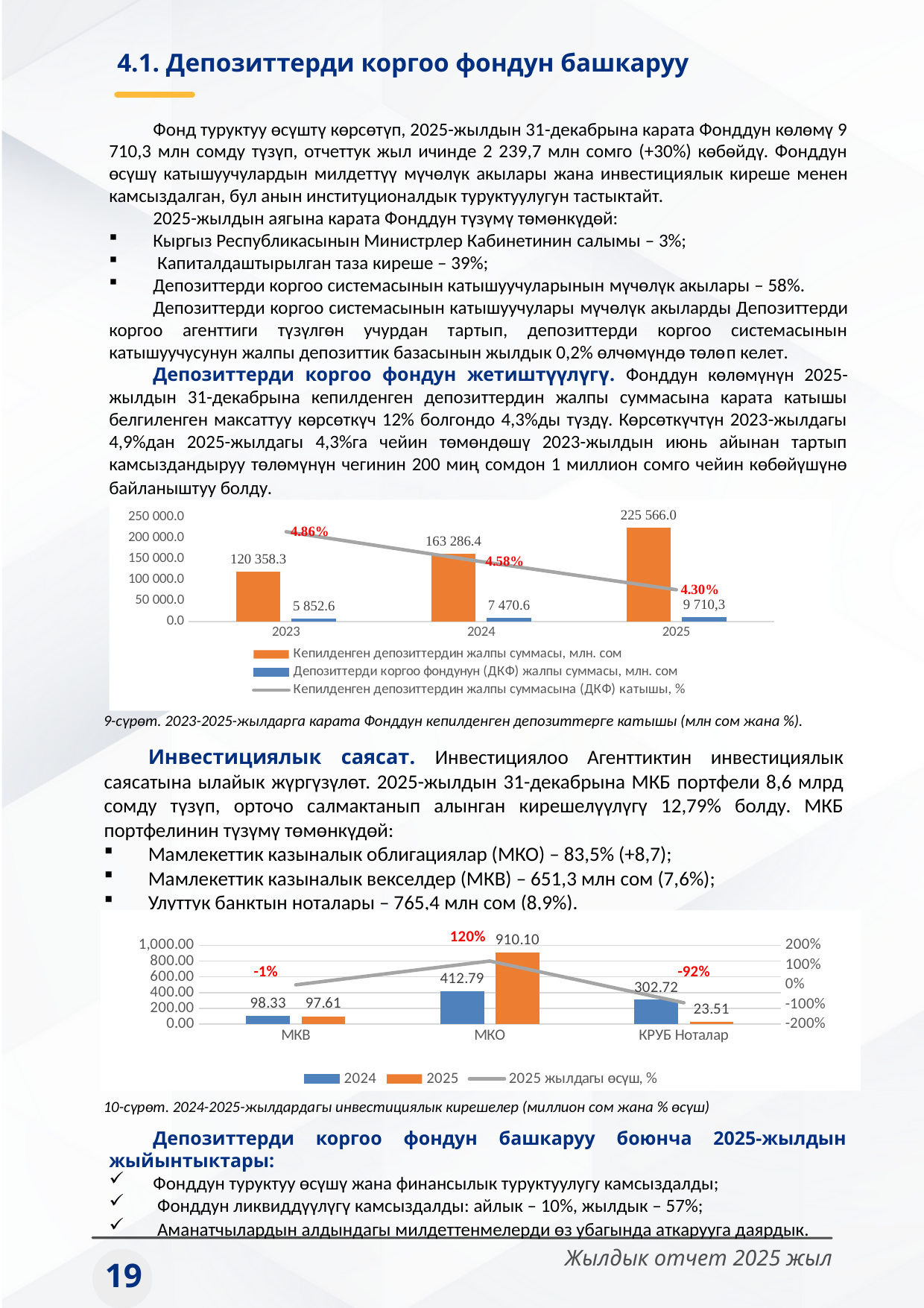
In the bottom chart, how many categories are shown on the x axis? 3 In the top chart, which year has the highest guaranteed deposits total (orange bar)? 2025 In the bottom chart, which category has the lowest 2025 value? КРУБ Ноталар In the bottom chart, what is the 2024 value for КРУБ Ноталар? 302.72 In the top chart, what ratio (%) is shown on the line for 2025? 4.30% In the bottom chart, what growth percentage is shown for КРУБ Ноталар? -92% In the top chart, what is the value of the ДКФ total (blue bar) for 2023? 5 852.6 In the top chart, does the ratio line rise or fall from 2023 to 2025? fall In the bottom chart, what is the difference between the 2025 and 2024 values for МКО? 497.31 In the bottom chart, what is the 2025 value for МКО? 910.10 In the top chart, how many entries does the legend list? 3 In the top chart, what is the value of the guaranteed deposits total (orange bar) for 2024? 163 286.4